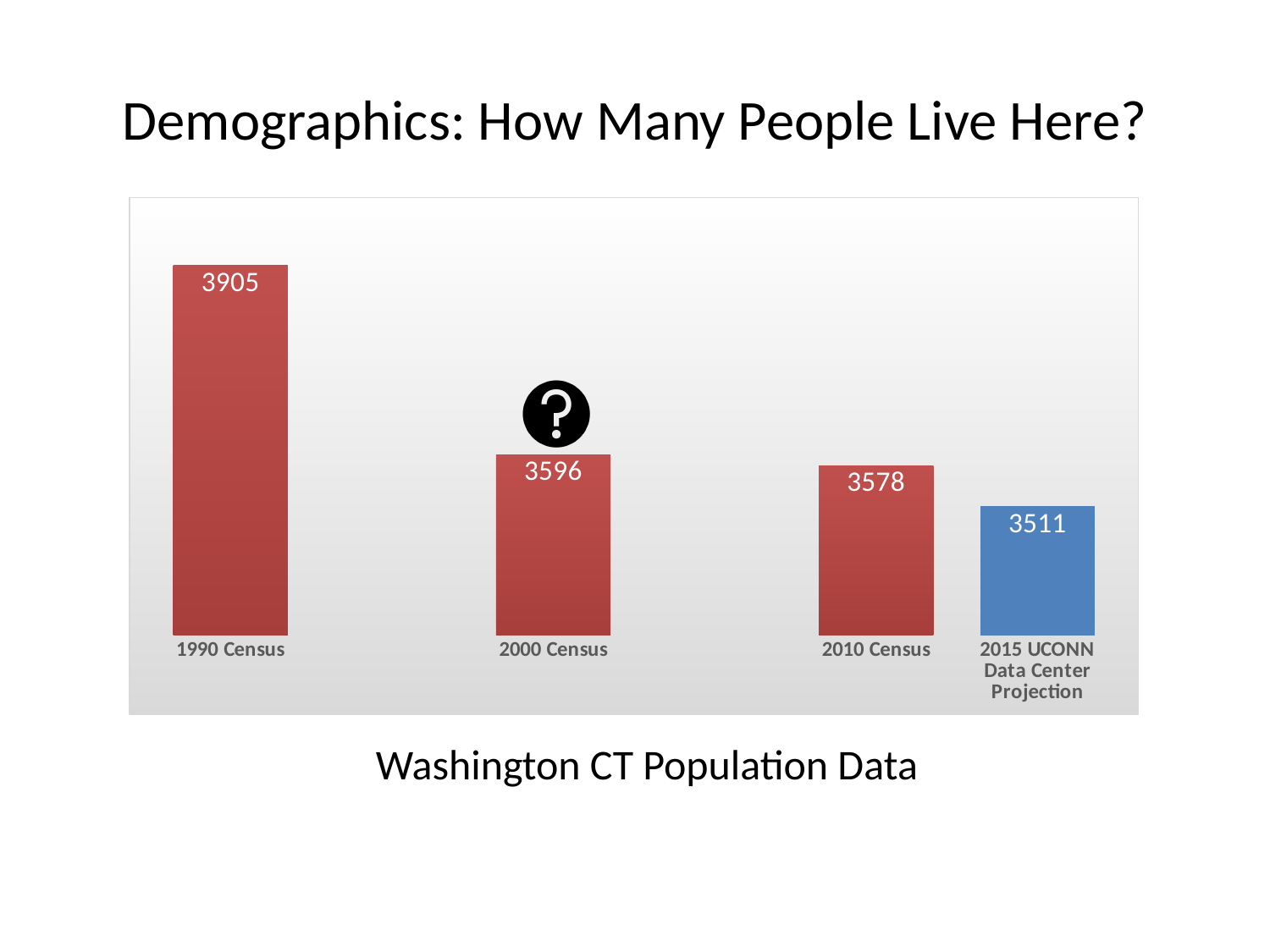
Which category has the lowest value? 2015 UCONN Data Center Projection What is the value for 1990 Census? 3905 What is the difference between the 2000 Census and 2010 Census values? 18 What is the value for 2010 Census? 3578 Which is larger, the 2010 Census value or the 2015 UCONN Data Center Projection value? 2010 Census How many categories are shown in the chart? 4 What is the value for the 2015 UCONN Data Center Projection? 3511 What is the difference between the 1990 Census and 2010 Census values? 327 What kind of chart is shown on the slide? Bar chart Do the values rise or fall from left to right across the chart? Fall Which category has the highest value? 1990 Census What is the value for 2000 Census? 3596